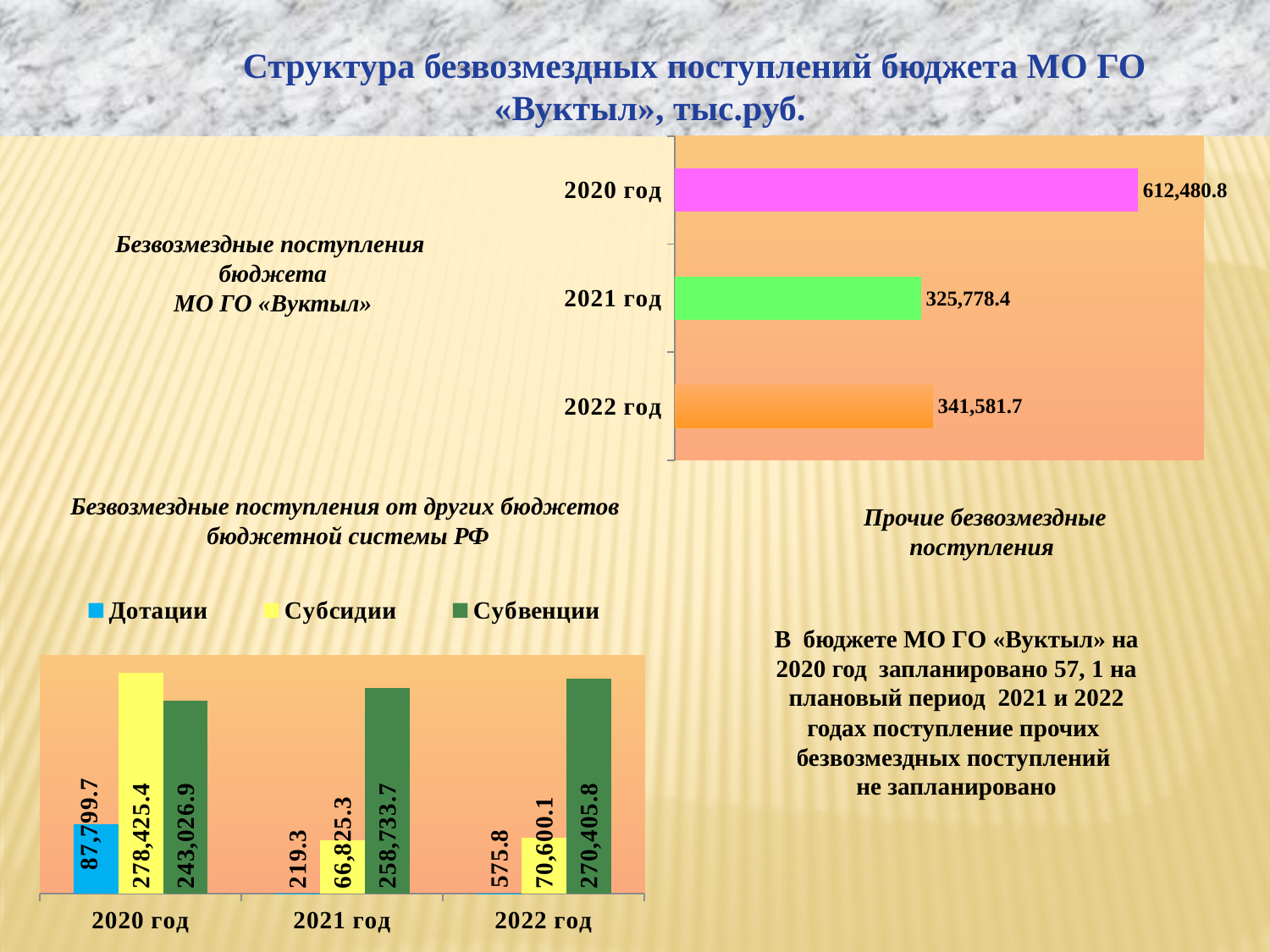
In the top-right chart (Безвозмездные поступления бюджета МО ГО «Вуктыл»), what is the value for 2021 год? 325,778.4 In the bottom-left chart (Безвозмездные поступления от других бюджетов бюджетной системы РФ), what is the value of Субсидии for 2020 год? 278,425.4 In the bottom-left chart (Безвозмездные поступления от других бюджетов бюджетной системы РФ), which is larger for 2021 год: Субсидии or Субвенции? Субвенции In the top-right chart (Безвозмездные поступления бюджета МО ГО «Вуктыл»), what is the difference between the 2020 год and 2021 год values? 286,702.4 In the top-right chart (Безвозмездные поступления бюджета МО ГО «Вуктыл»), what is the value for 2020 год? 612,480.8 In the bottom-left chart (Безвозмездные поступления от других бюджетов бюджетной системы РФ), how many series does the legend list? 3 What kind of chart is the top-right chart (Безвозмездные поступления бюджета МО ГО «Вуктыл»)? Bar chart In the top-right chart (Безвозмездные поступления бюджета МО ГО «Вуктыл»), which year has the lowest value? 2021 год In the top-right chart (Безвозмездные поступления бюджета МО ГО «Вуктыл»), how many years are shown? 3 In the bottom-left chart (Безвозмездные поступления от других бюджетов бюджетной системы РФ), what is the difference between Субвенции for 2022 год and 2021 год? 11,672.1 In the bottom-left chart (Безвозмездные поступления от других бюджетов бюджетной системы РФ), what is the value of Дотации for 2022 год? 575.8 In the top-right chart (Безвозмездные поступления бюджета МО ГО «Вуктыл»), which year has the highest value? 2020 год